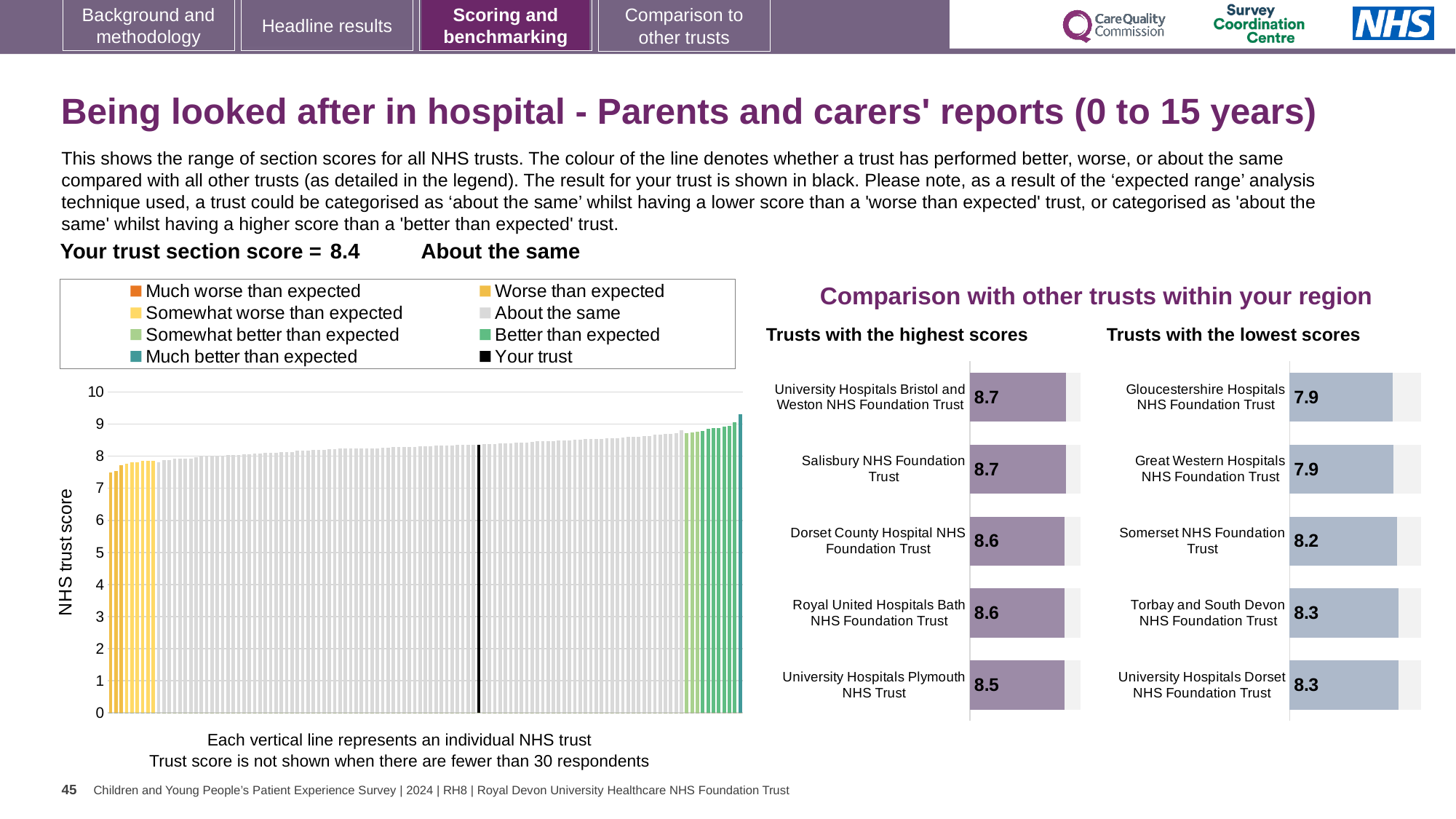
In the 'NHS trust score' chart on the left, do the bar values rise or fall from left to right? Rise In the 'Trusts with the highest scores' chart, what is the score for University Hospitals Bristol and Weston NHS Foundation Trust? 8.7 In the 'Trusts with the highest scores' chart, what is the difference between the scores of University Hospitals Bristol and Weston NHS Foundation Trust and University Hospitals Plymouth NHS Trust? 0.2 In the 'Trusts with the lowest scores' chart, what is the score for Gloucestershire Hospitals NHS Foundation Trust? 7.9 In the 'Trusts with the highest scores' chart, which has the higher score: Dorset County Hospital NHS Foundation Trust or University Hospitals Plymouth NHS Trust? Dorset County Hospital NHS Foundation Trust In the 'Trusts with the lowest scores' chart, what is the score for Somerset NHS Foundation Trust? 8.2 In the 'Trusts with the highest scores' chart, what is the score for Royal United Hospitals Bath NHS Foundation Trust? 8.6 How many entries does the legend above the 'NHS trust score' chart list? 8 What kind of chart is the 'NHS trust score' chart on the left of the slide? Bar chart In the 'NHS trust score' chart on the left, what colour is used for 'Your trust'? Black How many trusts are listed in the 'Trusts with the lowest scores' chart? 5 In the 'Trusts with the lowest scores' chart, what is the difference between the scores of Somerset NHS Foundation Trust and Great Western Hospitals NHS Foundation Trust? 0.3